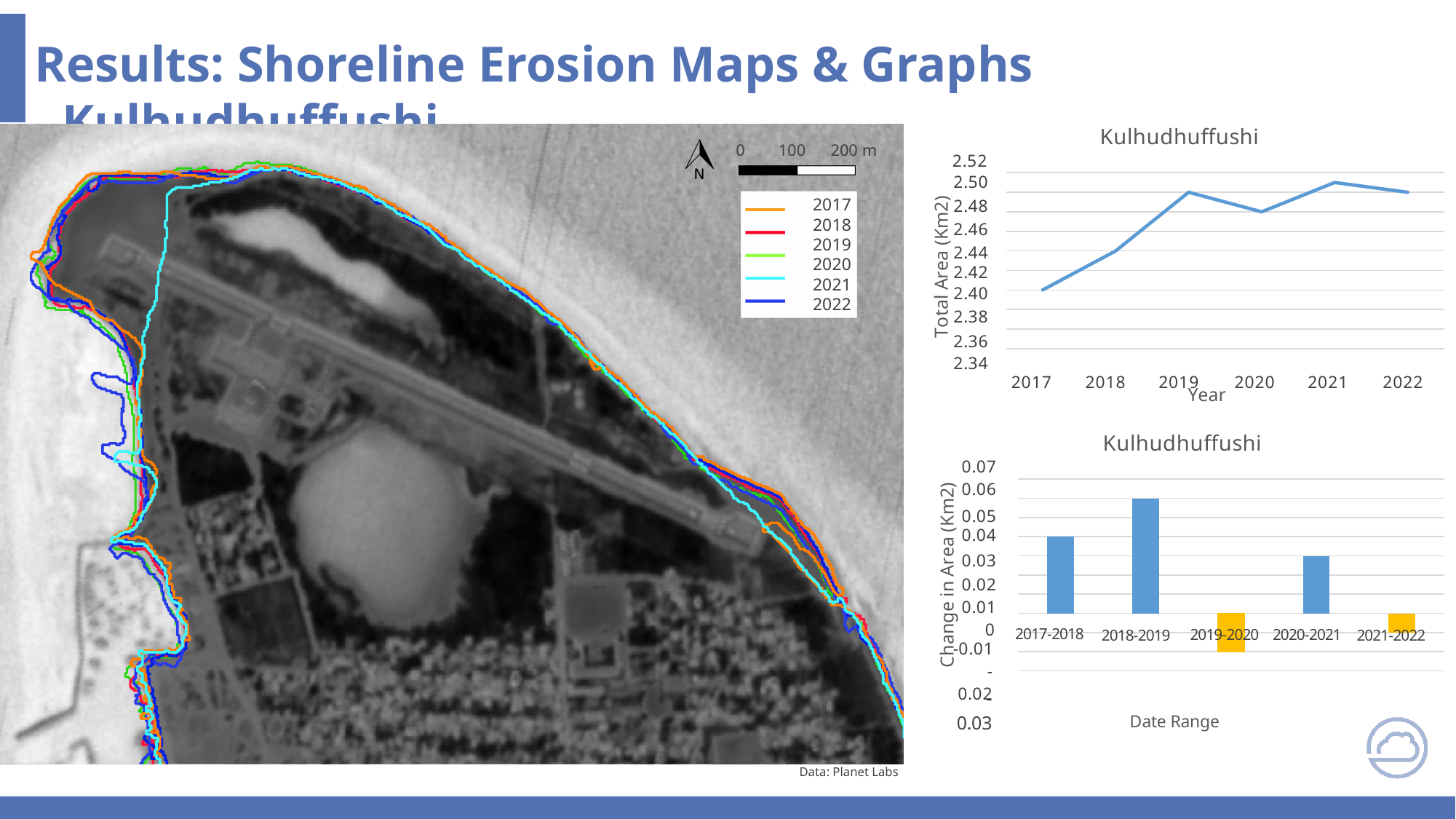
In the top line chart, is the total area for 2018 greater or less than 2.46? less In the top line chart, which year has a larger total area, 2019 or 2020? 2019 In the top line chart, which year has the highest total area? 2021 In the bottom bar chart, which date range has the largest change in area? 2018-2019 In the bottom bar chart, which date range has the lowest change in area? 2019-2020 In the top line chart, which year has the lowest total area? 2017 In the bottom bar chart, how many date ranges are shown? 5 In the bottom bar chart, is the change in area for 2018-2019 greater or less than 0.05? greater What kind of chart is the bottom chart on the right titled Kulhudhuffushi? bar chart In the top line chart, how many years are plotted along the x axis? 6 What kind of chart is the top chart on the right titled Kulhudhuffushi? line chart In the top line chart, does the total area rise or fall from 2017 to 2019? rise